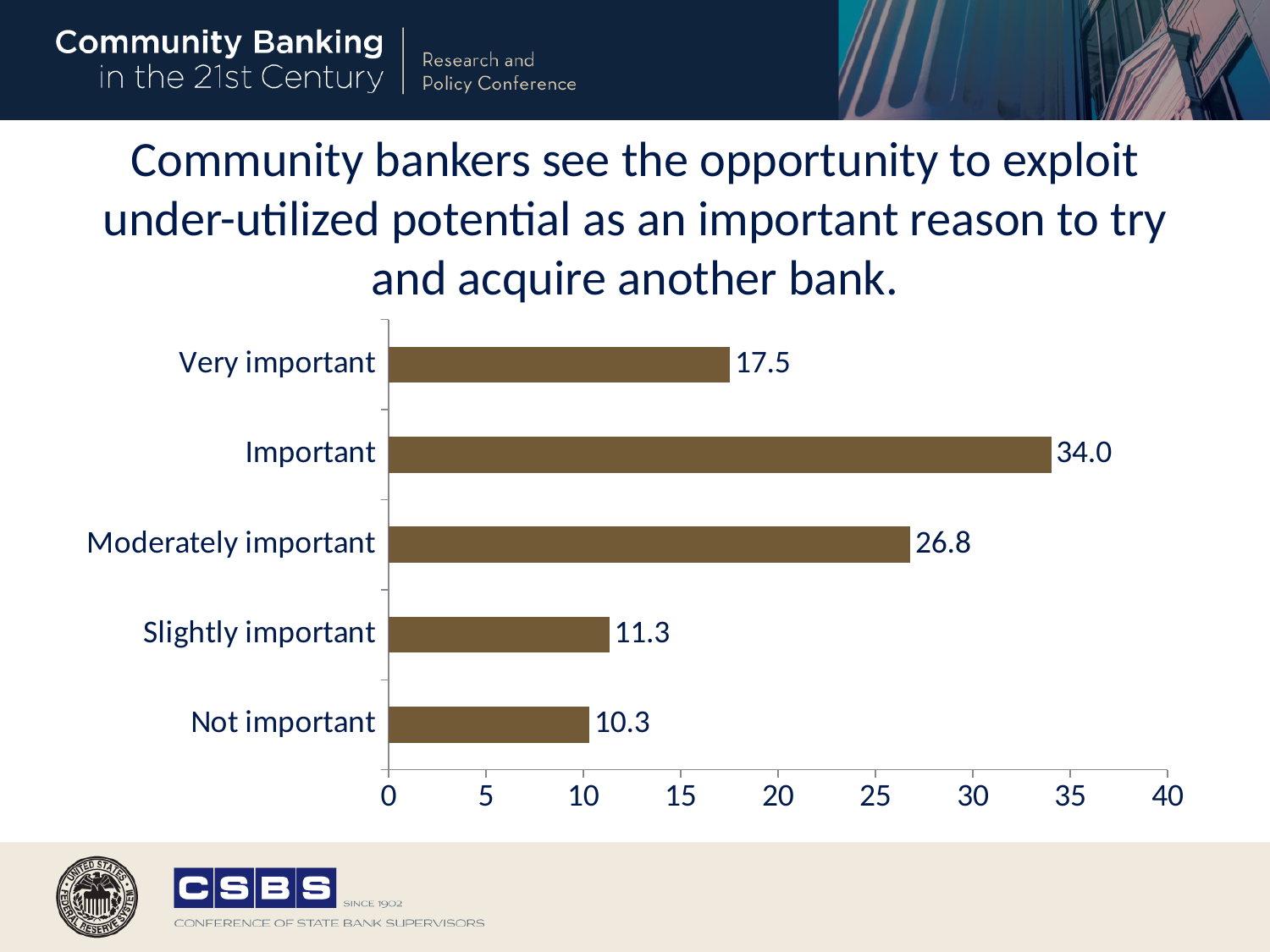
Which category has the lowest value? Not important How many categories are shown in the chart? 5 Is the value for Moderately important greater or less than 25? greater What is the value for Moderately important? 26.8 Which is larger, the value for Very important or the value for Slightly important? Very important What is the value for Not important? 10.3 What is the value for Very important? 17.5 What is the difference between the values for Important and Moderately important? 7.2 What kind of chart is shown on the slide? Bar chart What is the maximum value shown on the horizontal axis? 40 What is the value for Important? 34.0 Which category has the highest value? Important